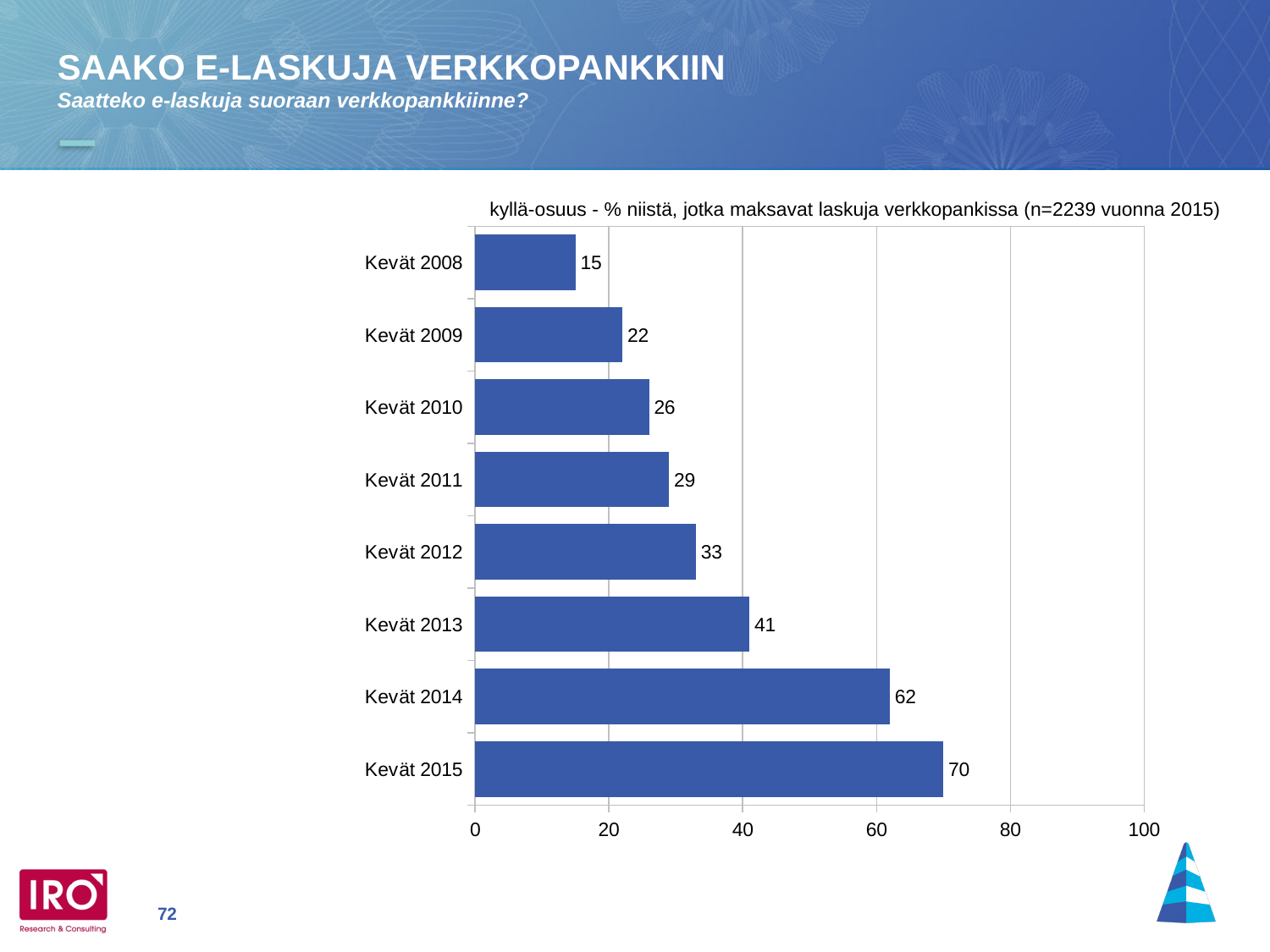
What kind of chart is shown on the slide? bar chart What is the value for Kevät 2013? 41 Is the value for Kevät 2014 greater or less than 60? greater What is the value for Kevät 2008? 15 Which is larger, the value for Kevät 2011 or the value for Kevät 2010? Kevät 2011 What is the value for Kevät 2015? 70 What is the difference between the values for Kevät 2015 and Kevät 2014? 8 Which category has the lowest value? Kevät 2008 How many categories are shown in the chart? 8 What is the difference between the values for Kevät 2013 and Kevät 2012? 8 Which category has the highest value? Kevät 2015 Do the values rise or fall from Kevät 2008 to Kevät 2015? rise